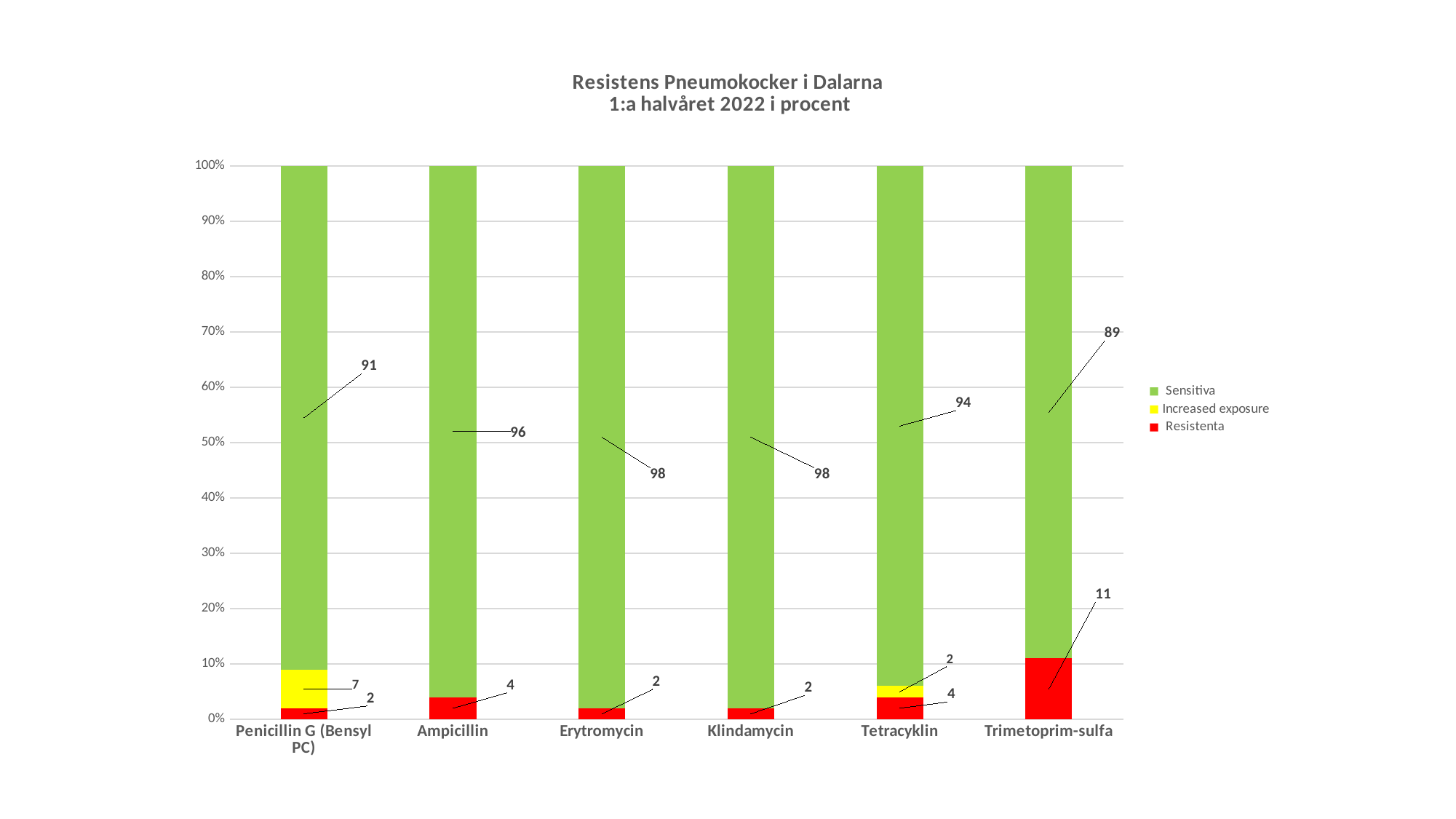
What is the Resistenta value for Trimetoprim-sulfa? 11 What is the Increased exposure value for Penicillin G (Bensyl PC)? 7 Which has the larger Resistenta value, Ampicillin or Erytromycin? Ampicillin Which antibiotic has the lowest Sensitiva value? Trimetoprim-sulfa What is the Increased exposure value for Tetracyklin? 2 Which antibiotic has the highest Resistenta value? Trimetoprim-sulfa What is the Sensitiva value for Penicillin G (Bensyl PC)? 91 What is the difference between the Sensitiva values for Ampicillin and Penicillin G (Bensyl PC)? 5 What colour represents the Resistenta series? Red How many series does the legend list? 3 What kind of chart is shown on the slide? Stacked bar chart How many antibiotics are shown on the x axis? 6